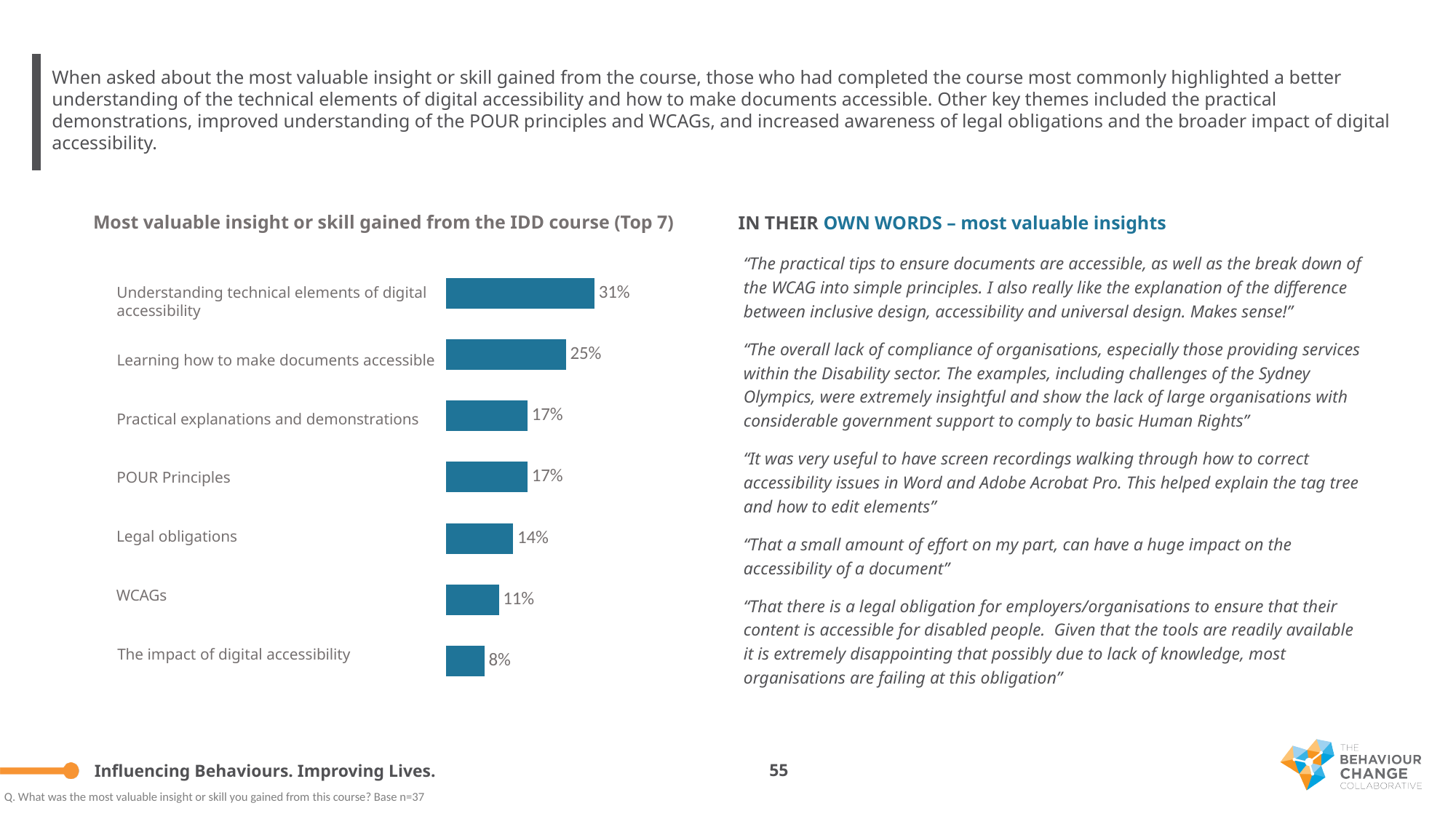
What is the value for 'WCAGs'? 11% Which category has the highest value in the chart? Understanding technical elements of digital accessibility What percentage is shown for 'Legal obligations'? 14% What is the difference between the values for 'Understanding technical elements of digital accessibility' and 'Learning how to make documents accessible'? 6% What is the difference between the values for 'Legal obligations' and 'The impact of digital accessibility'? 6% Which category has the lowest value in the chart? The impact of digital accessibility Which is larger: the value for 'Legal obligations' or the value for 'WCAGs'? Legal obligations How many categories are shown in the chart? 7 What percentage of respondents cited 'Understanding technical elements of digital accessibility' as the most valuable insight or skill gained? 31% What type of chart is used on the slide? Bar chart What is the value shown for 'Learning how to make documents accessible'? 25% What is the title of the chart? Most valuable insight or skill gained from the IDD course (Top 7)